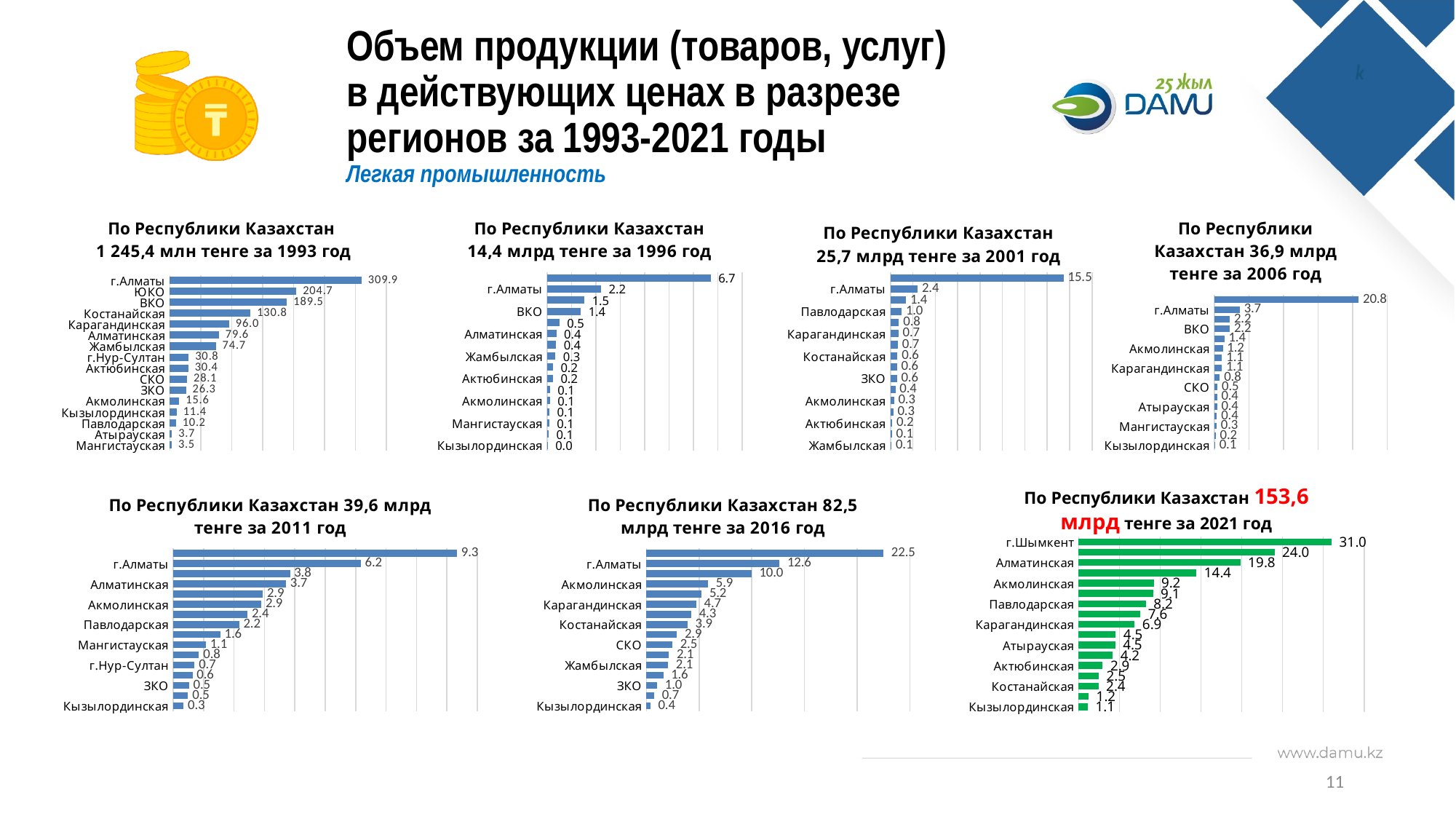
In the chart 'По Республики Казахстан 1 245,4 млн тенге за 1993 год', what is the value for Костанайская? 130.8 In the chart 'По Республики Казахстан 153,6 млрд тенге за 2021 год', which is larger, the value for Акмолинская or for Павлодарская? Акмолинская In the chart 'По Республики Казахстан 153,6 млрд тенге за 2021 год', what is the value for г.Шымкент? 31.0 In the chart 'По Республики Казахстан 82,5 млрд тенге за 2016 год', what is the largest value shown? 22.5 In the chart 'По Республики Казахстан 1 245,4 млн тенге за 1993 год', how many regions are plotted? 16 What type of chart is used for the 1993 data on this slide? Bar chart In the chart 'По Республики Казахстан 1 245,4 млн тенге за 1993 год', which region has the lowest value? Мангистауская In the chart 'По Республики Казахстан 153,6 млрд тенге за 2021 год', which region has the highest value? г.Шымкент How many charts are shown on the slide? 7 In the chart 'По Республики Казахстан 153,6 млрд тенге за 2021 год', what is the difference between the values for г.Шымкент and Алматинская? 11.2 In the chart 'По Республики Казахстан 1 245,4 млн тенге за 1993 год', what is the difference between the values for ЮКО and ВКО? 15.2 In the chart 'По Республики Казахстан 1 245,4 млн тенге за 1993 год', what is the value for г.Алматы? 309.9